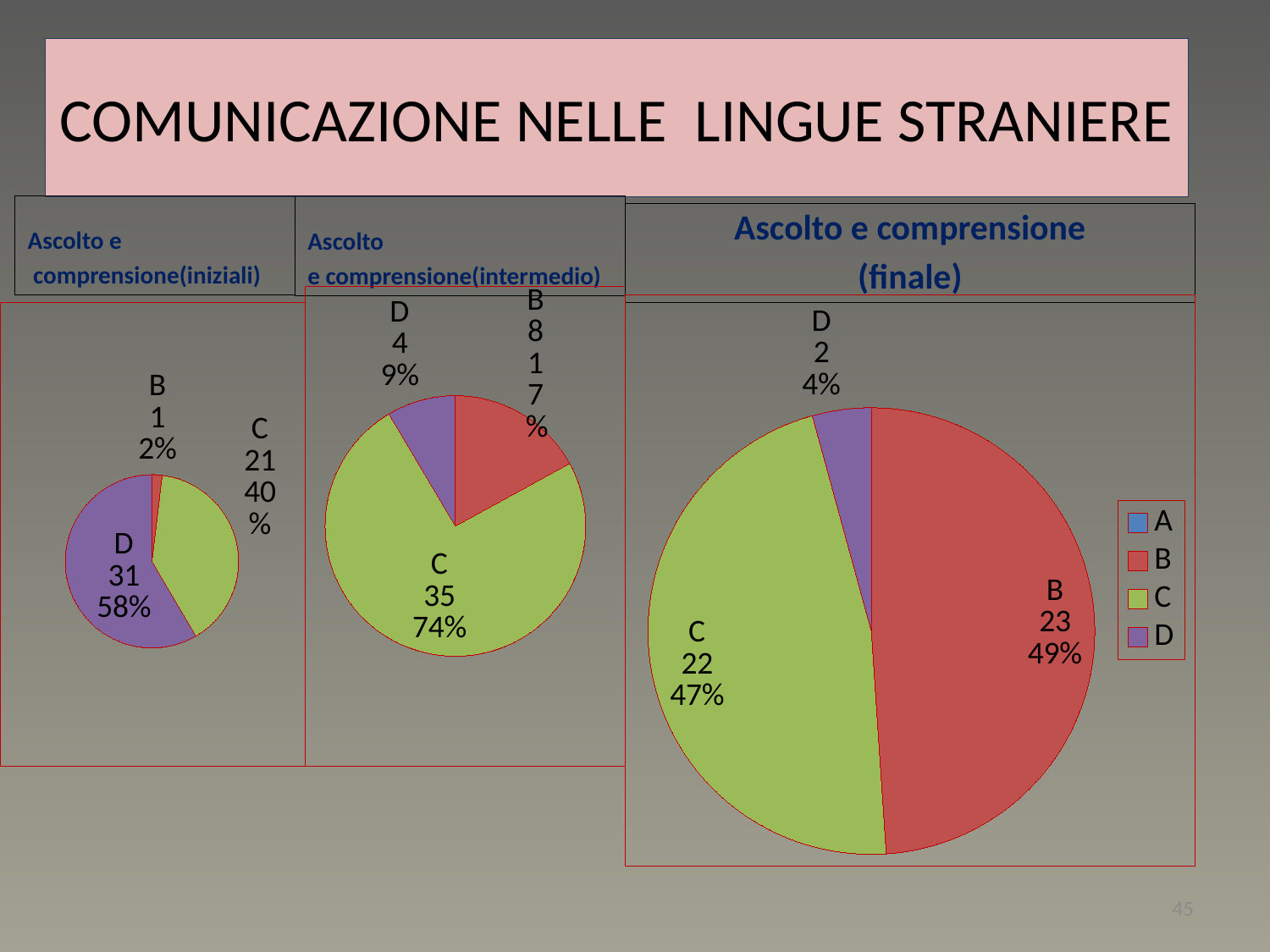
In the 'Ascolto e comprensione (finale)' chart, what is the value for B? 23 What type of chart is 'Ascolto e comprensione (finale)'? Pie chart In the 'Ascolto e comprensione (finale)' chart, what is the difference between the values for B and C? 1 In the 'Ascolto e comprensione(iniziali)' chart, which category has the smallest slice? B In the 'Ascolto e comprensione(iniziali)' chart, what percentage share does C have? 40% In the 'Ascolto e comprensione (finale)' chart, how many entries does the legend list? 4 In the 'Ascolto e comprensione(intermedio)' chart, what is the value for C? 35 In the 'Ascolto e comprensione(intermedio)' chart, what percentage share does D have? 9% In the 'Ascolto e comprensione(iniziali)' chart, what is the value for D? 31 In the 'Ascolto e comprensione(intermedio)' chart, what is the difference between the values for C and B? 27 In the 'Ascolto e comprensione(intermedio)' chart, which category has the largest slice? C In the 'Ascolto e comprensione (finale)' chart, what percentage share does C have? 47%